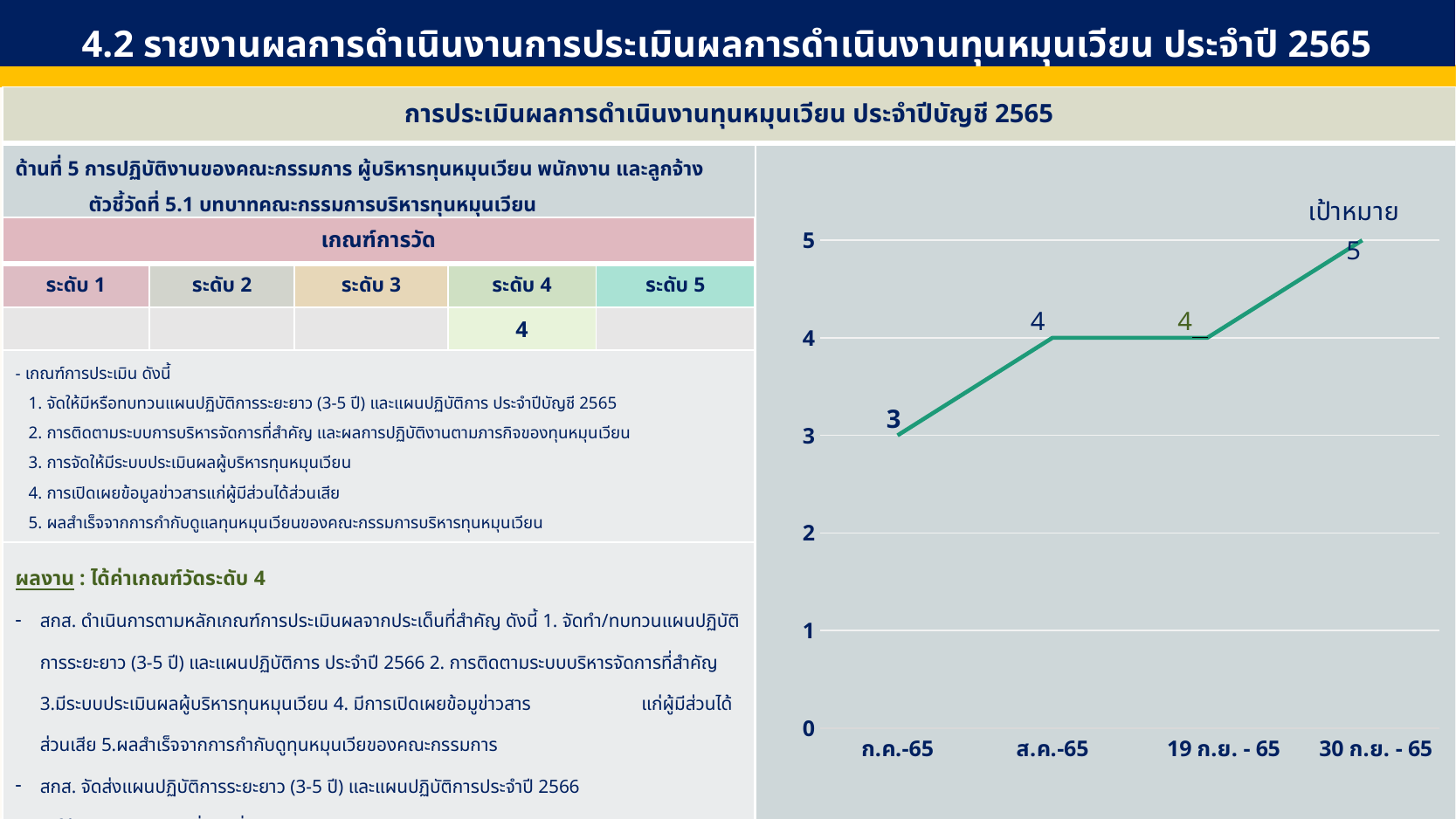
What label is written above the last point of the line chart? เป้าหมาย What is the difference between the value for 30 ก.ย. - 65 and the value for ก.ค.-65? 2 What is the value plotted for ก.ค.-65? 3 Which x-axis category has the highest value on the line chart? 30 ก.ย. - 65 What kind of chart is shown on the right side of the slide? line chart What is the value plotted for 19 ก.ย. - 65? 4 Which x-axis category has the lowest value on the line chart? ก.ค.-65 What is the value plotted for ส.ค.-65? 4 Which is larger, the value for ส.ค.-65 or the value for ก.ค.-65? ส.ค.-65 What is the value plotted for 30 ก.ย. - 65? 5 Do the values on the line chart rise or fall from ก.ค.-65 to 30 ก.ย. - 65? rise How many data points are plotted on the line chart? 4